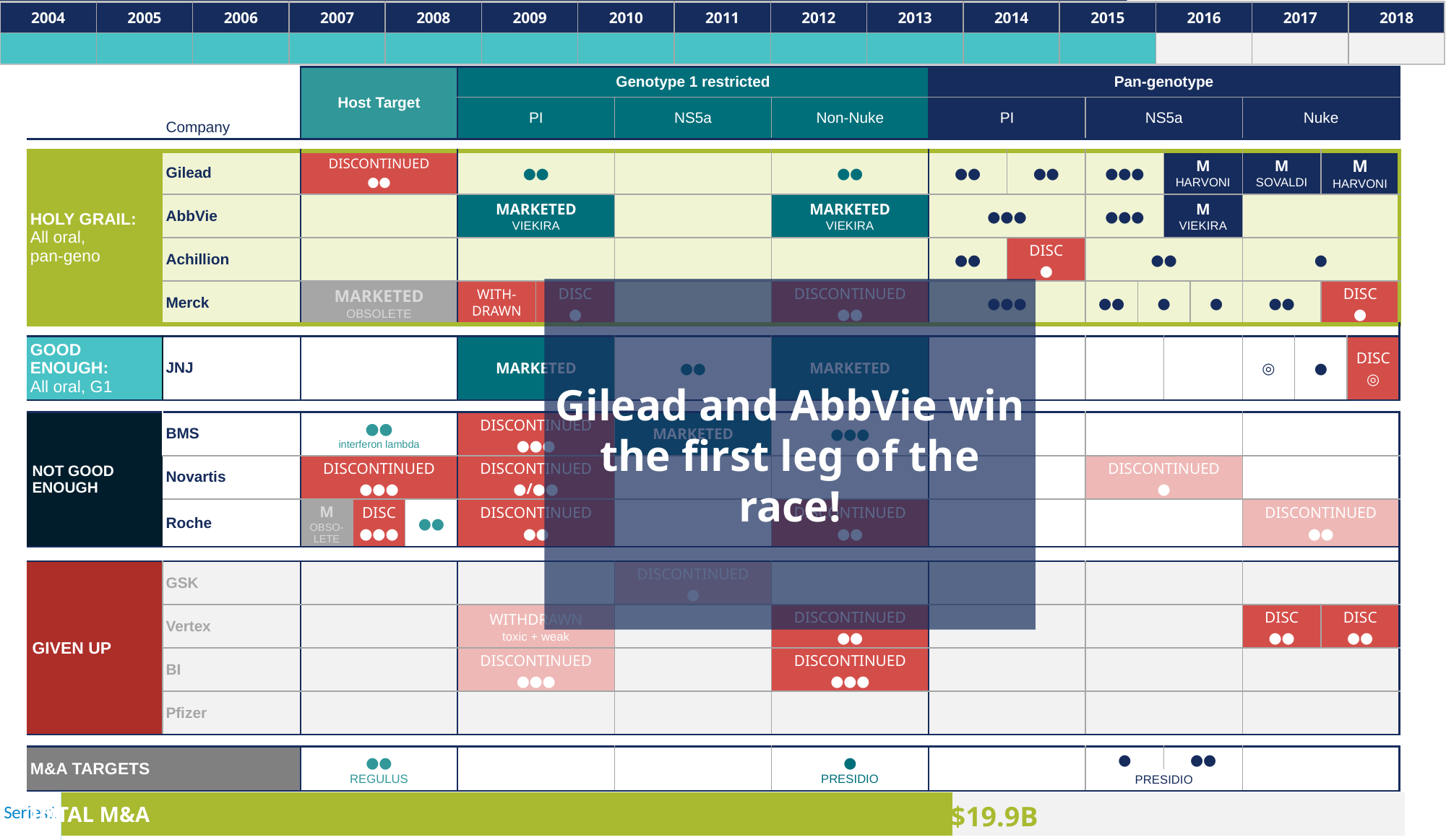
What series label is shown at the left of the TOTAL M&A bar at the bottom of the slide? Series1 On the bar at the bottom of the slide, what value is printed for TOTAL M&A? $19.9B In the timeline bar across the top of the slide, what is the last year the teal shading covers? 2015 How many bars are plotted in the TOTAL M&A chart at the bottom of the slide? 1 What kind of chart is the TOTAL M&A graphic at the bottom of the slide? bar chart In the timeline bar across the top of the slide, what is the first year shown? 2004 How many year columns are shown in the timeline bar across the top of the slide? 15